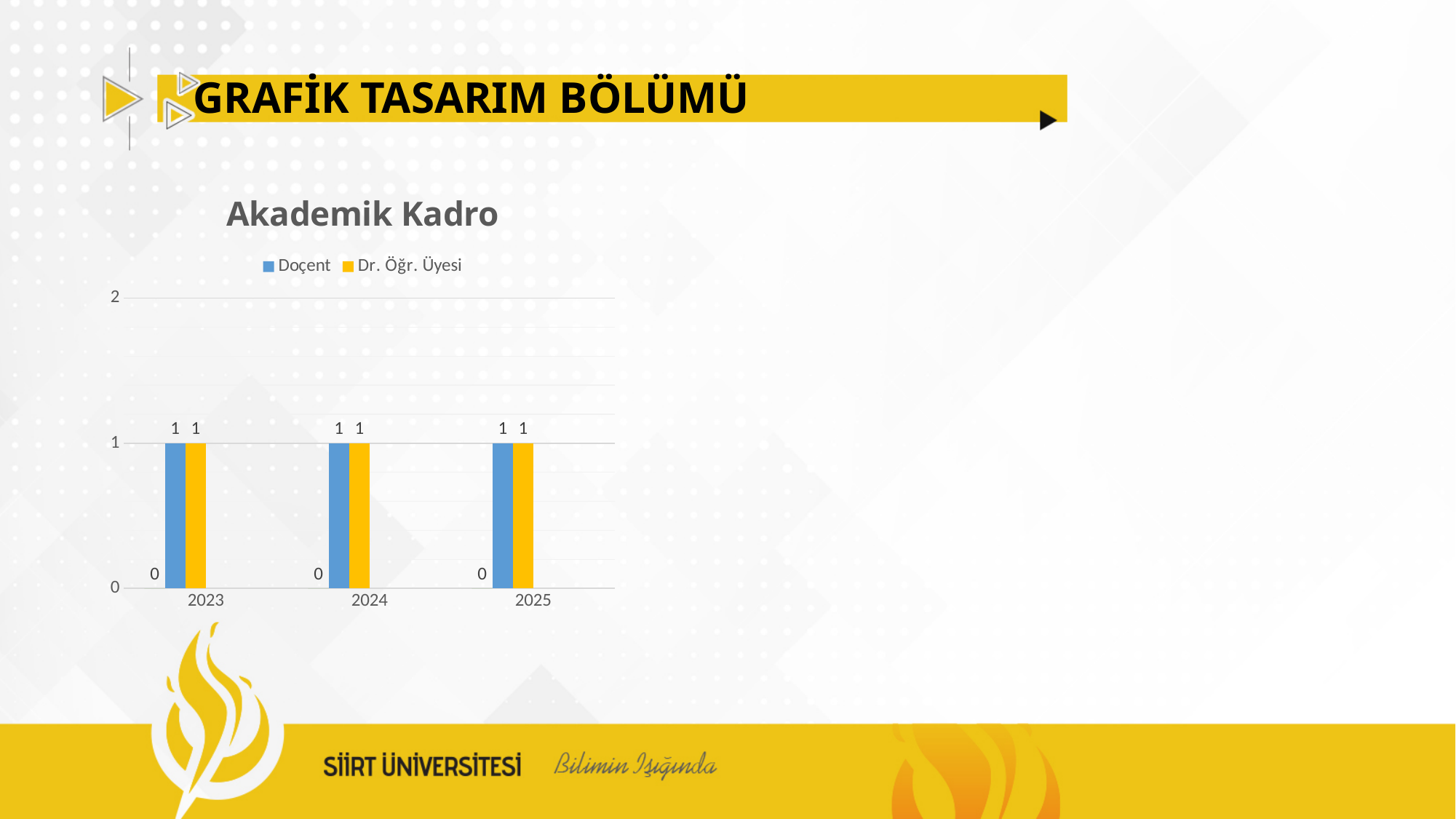
What is the value for Doçent in 2023? 1 What kind of chart is shown on the slide? Bar chart What is the value for Doçent in 2025? 1 How many series does the legend list? 2 Which colour represents Dr. Öğr. Üyesi in the chart? Yellow What is the difference between the Doçent and Dr. Öğr. Üyesi values in 2024? 0 Does the value for Doçent rise, fall or stay the same from 2023 to 2025? Stays the same How many years are shown on the x axis? 3 Is the value for Dr. Öğr. Üyesi in 2023 greater or less than 2? less What is the value for Dr. Öğr. Üyesi in 2024? 1 What is the title of the chart? Akademik Kadro What is the value for Dr. Öğr. Üyesi in 2025? 1